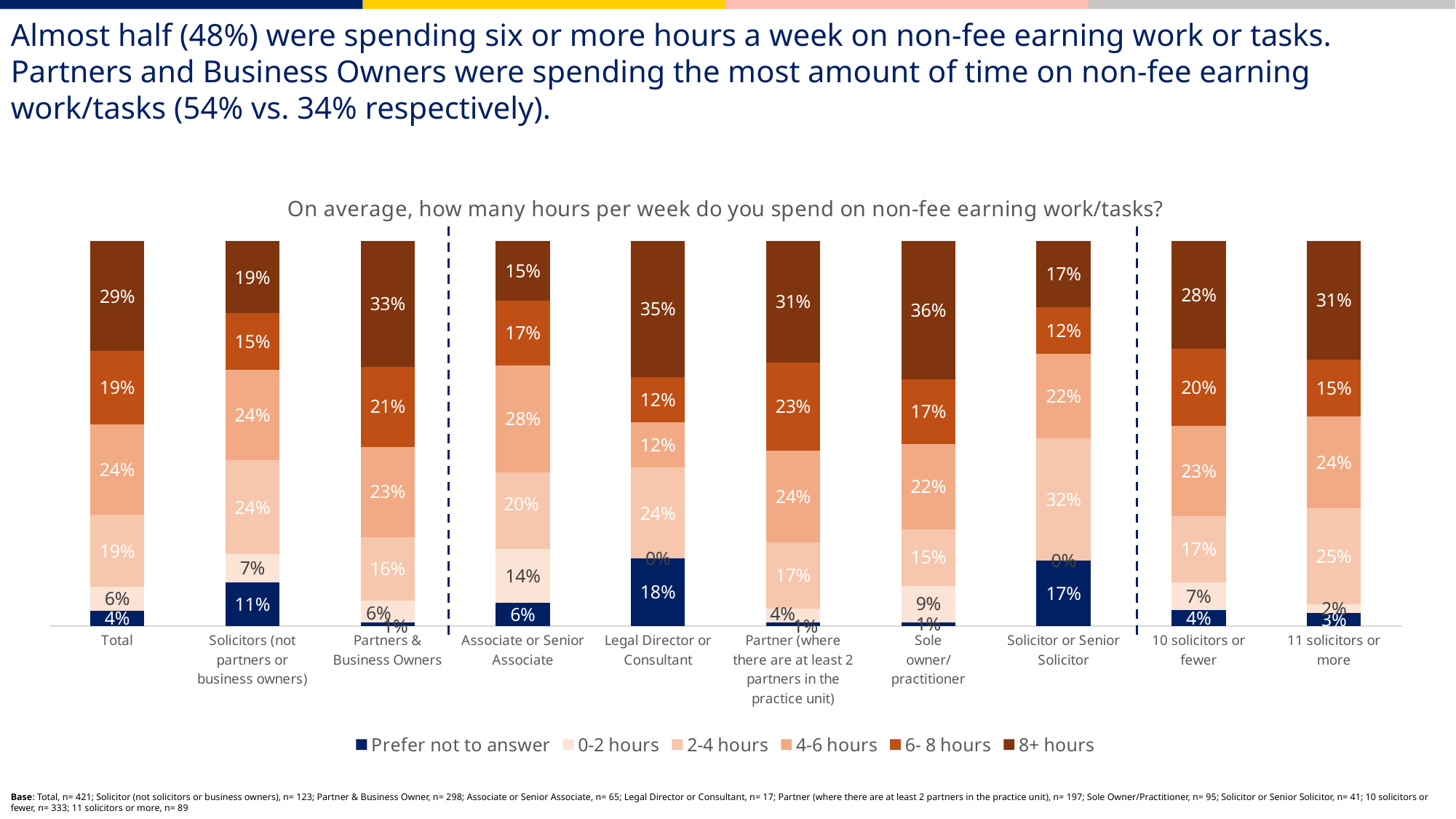
What type of chart is shown on the slide? Stacked bar chart What is the difference between the 8+ hours share for Partners & Business Owners and for Solicitors (not partners or business owners)? 14 percentage points What percentage of Legal Director or Consultant respondents chose 'Prefer not to answer'? 18% Which category has the highest share of respondents spending 8+ hours per week? Sole owner/practitioner What percentage of Solicitor or Senior Solicitor respondents spend 2-4 hours per week on non-fee earning work/tasks? 32% What percentage of the Total group spend 8+ hours per week on non-fee earning work/tasks? 29% Which has a larger 0-2 hours share: Associate or Senior Associate, or Sole owner/practitioner? Associate or Senior Associate How many categories are shown along the x axis of the chart? 10 Which category has the lowest share of respondents spending 8+ hours per week? Associate or Senior Associate What percentage of Partners & Business Owners spend 6-8 hours per week on non-fee earning work/tasks? 21% How many series does the chart legend list? 6 What is the title of the chart? On average, how many hours per week do you spend on non-fee earning work/tasks?